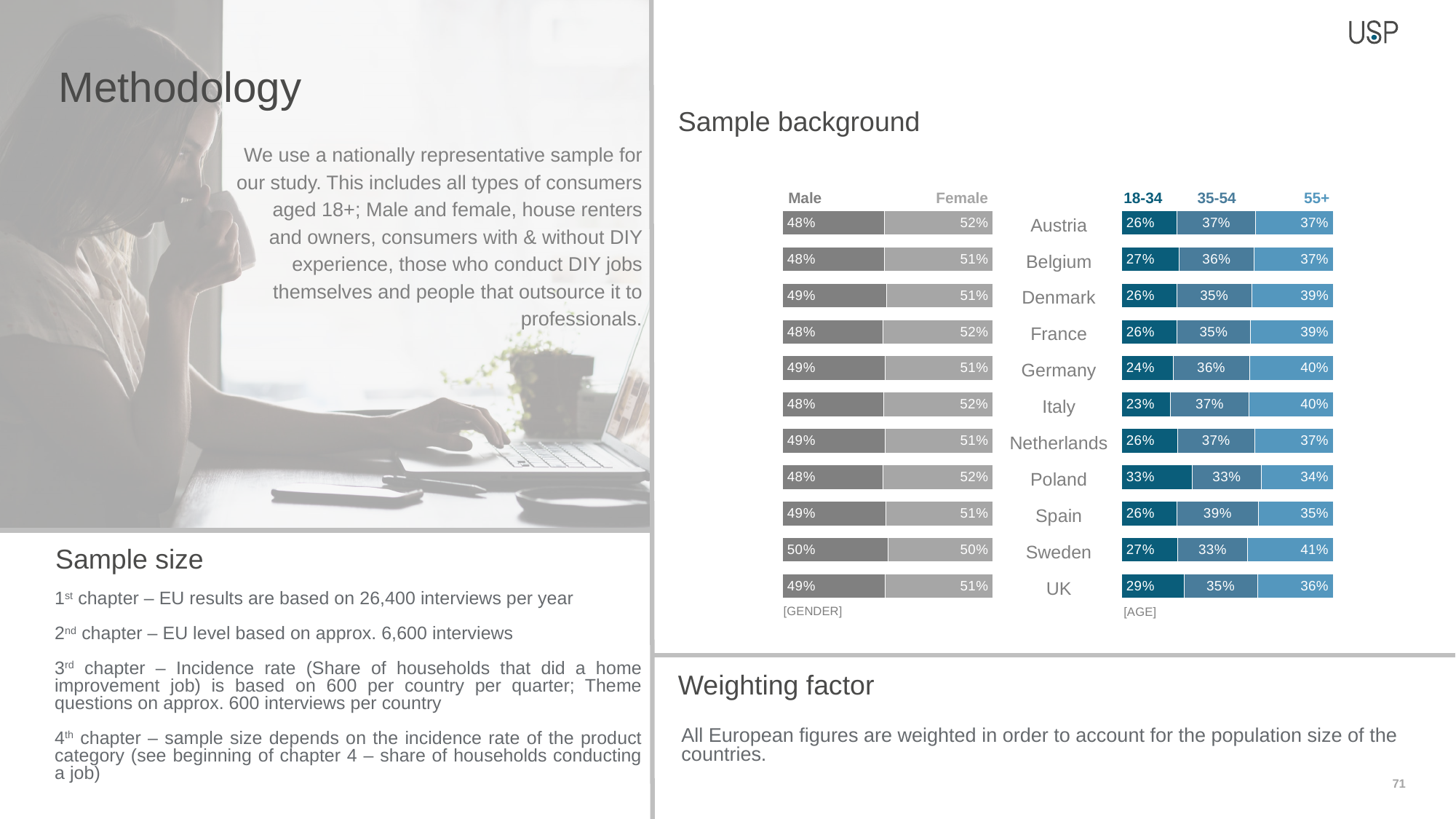
In the age chart, which is larger: the 35-54 share for Spain or for Austria? Spain In the age chart, which country has the highest 18-34 share? Poland How many age groups does the age chart show? 3 In the age chart, which country has the lowest 18-34 share? Italy What type of chart is used for the gender breakdown? Bar chart In the age chart, what is the value for the 18-34 group in the UK? 29% In the age chart, what is the difference between the 55+ and 18-34 shares for Germany? 16 percentage points In the gender chart, what is the total of the Male and Female shares for Austria? 100% In the age chart, what is the value for the 18-34 group in Poland? 33% How many countries are shown in the gender chart? 11 In the age chart, which country has the highest 55+ share? Sweden In the gender chart, what is the Male share for Sweden? 50%